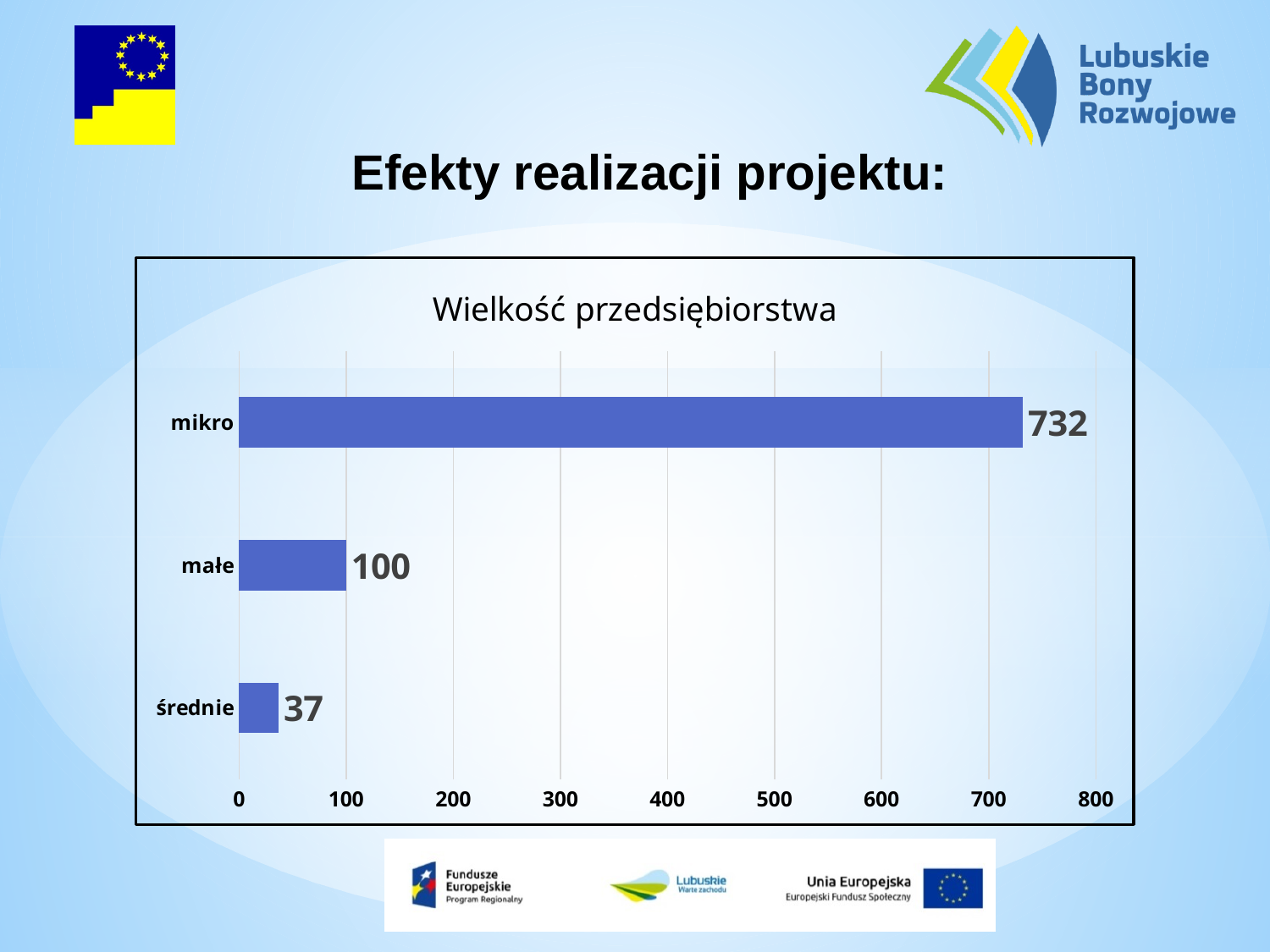
What is the value for średnie? 37 What is the value for małe? 100 Is the value for mikro greater or less than 700? greater What is the value for mikro? 732 Which category has the highest value? mikro How many categories are shown in the chart? 3 What kind of chart is shown on the slide? bar chart Which is larger, the value for małe or the value for średnie? małe What is the difference between the values for mikro and małe? 632 What is the title of the chart? Wielkość przedsiębiorstwa What is the difference between the values for małe and średnie? 63 Which category has the lowest value? średnie